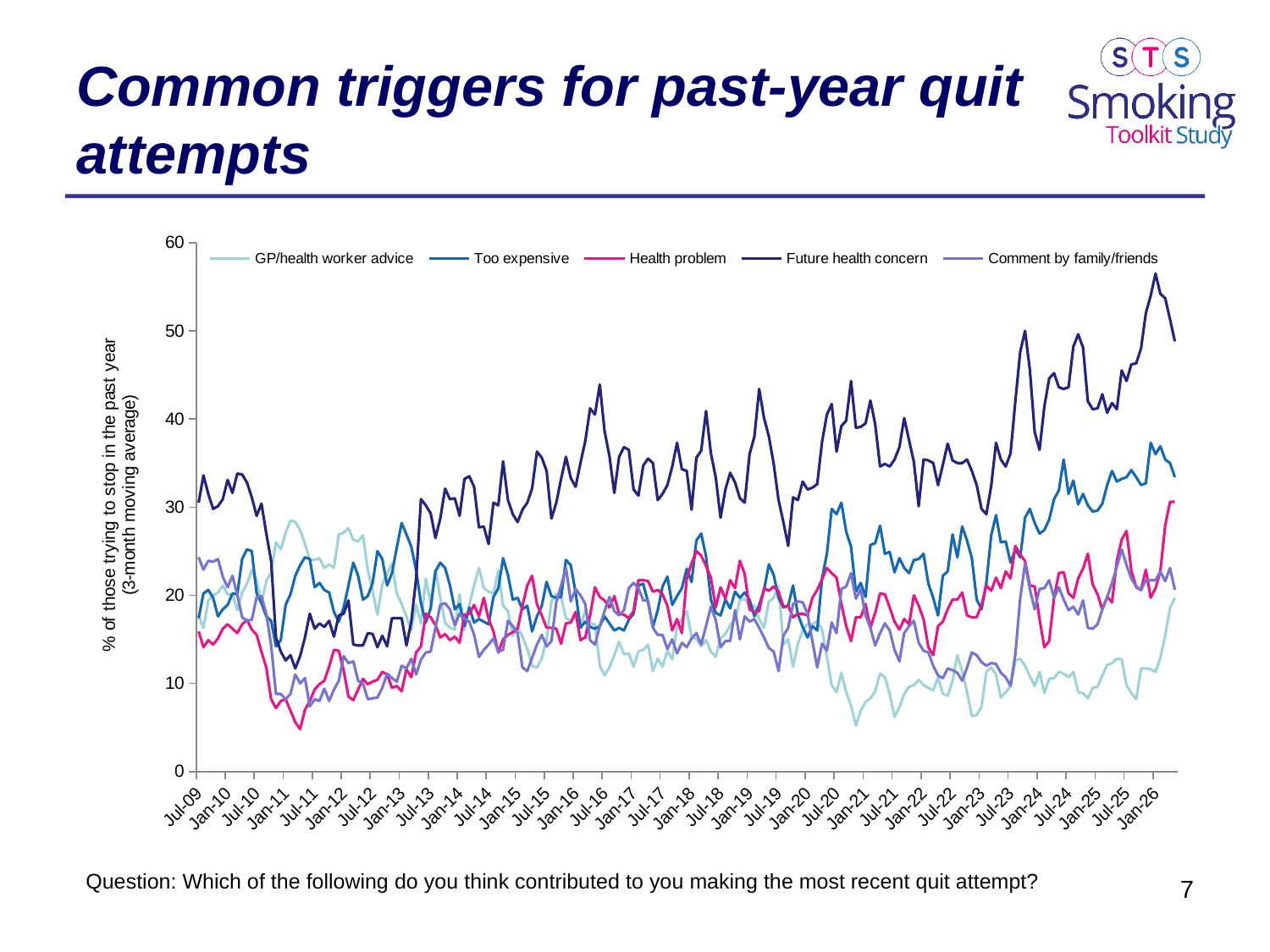
Around Jan-21, which is larger: Too expensive or GP/health worker advice? Too expensive What are the five series listed in the legend? GP/health worker advice, Too expensive, Health problem, Future health concern, Comment by family/friends Is the value for Too expensive around Jan-26 greater or less than 30? greater How many series does the legend list? 5 Is the peak value for Future health concern near the end of the chart (around Jan-26) greater or less than 50? greater Is the lowest value for Health problem (around Jul-11) greater or less than 10? less Which series has the highest value at the right-hand end of the chart (around Jan-26)? Future health concern What kind of chart is shown on the slide? line chart Around Jan-26, which is larger: Future health concern or Too expensive? Future health concern Which series has the lowest value around Jan-21? GP/health worker advice Does the Future health concern series rise or fall overall between Jan-23 and Jan-26? rise